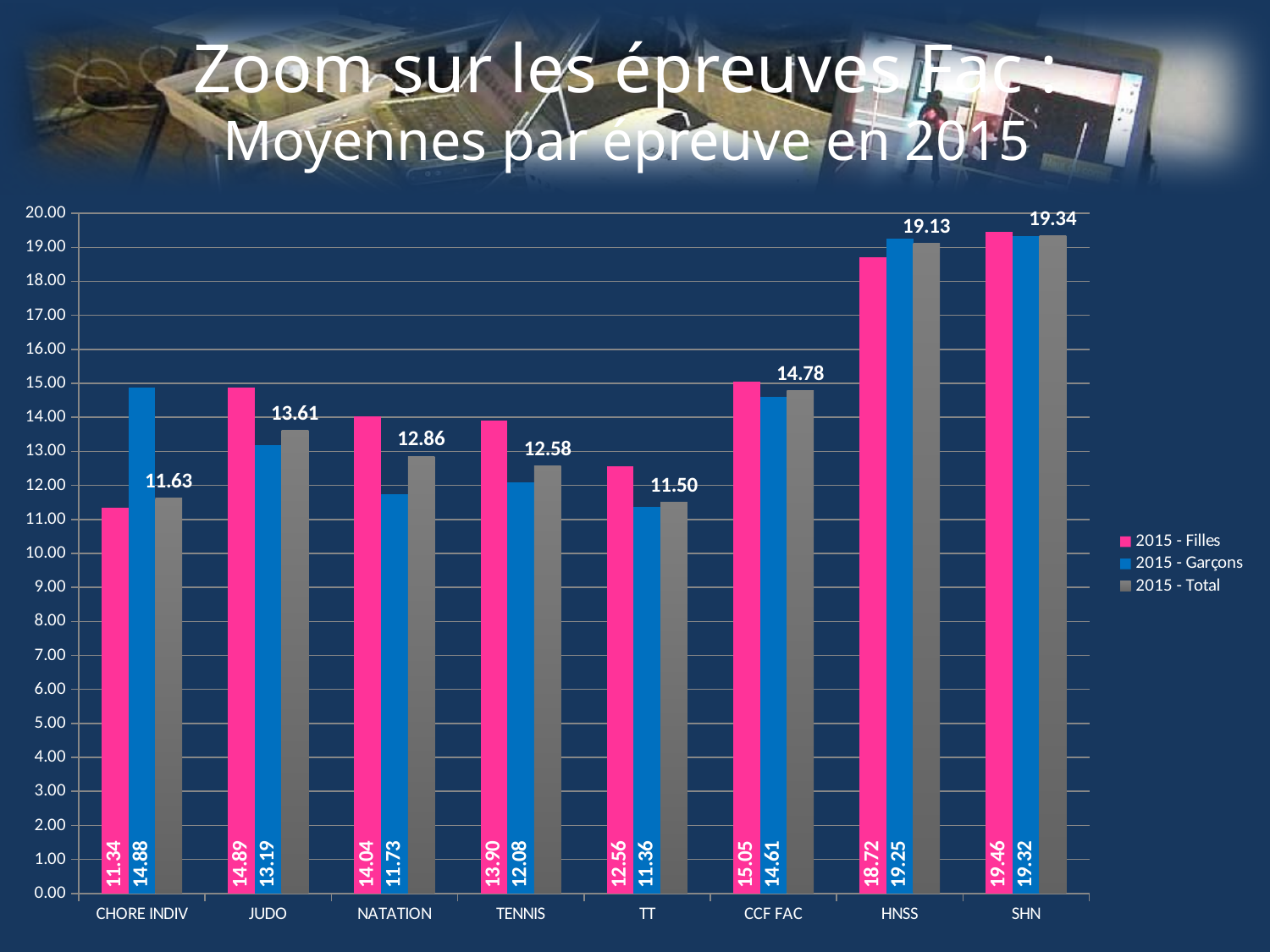
What is the value for 2015 - Garçons in HNSS? 19.25 How many series does the legend list? 3 What is the value for 2015 - Garçons in NATATION? 11.73 What kind of chart is shown on the slide? Bar chart What is the value for 2015 - Filles in JUDO? 14.89 Which colour represents the 2015 - Total series? Grey What is the value for 2015 - Total in CCF FAC? 14.78 How many categories are shown on the x axis? 8 Which is larger in TENNIS: the 2015 - Filles value or the 2015 - Garçons value? 2015 - Filles What is the difference between the 2015 - Garçons and 2015 - Filles values in CHORE INDIV? 3.54 Which category has the lowest value for 2015 - Filles? CHORE INDIV Which category has the highest value for 2015 - Total? SHN